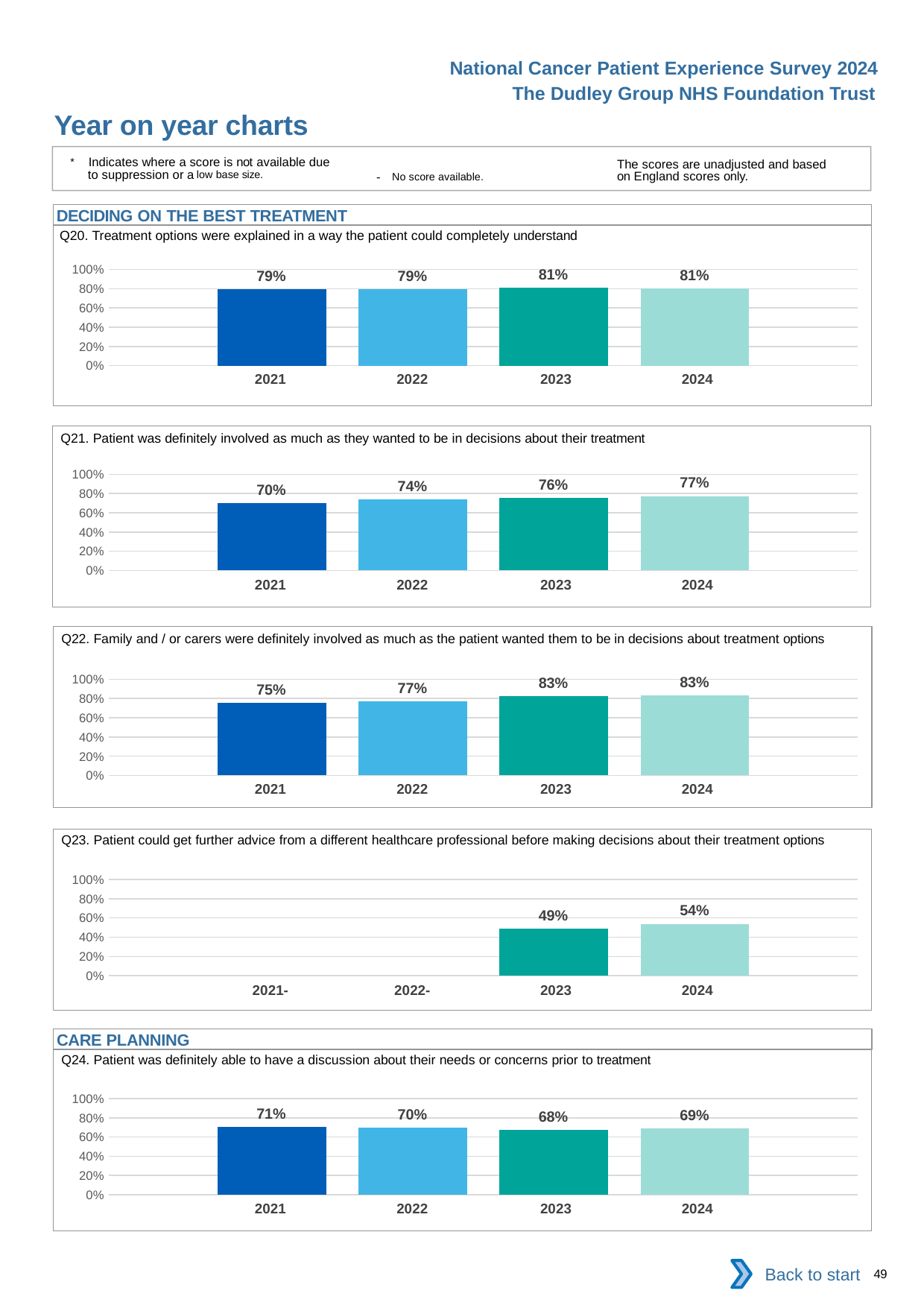
In the Q21 chart, which year has the highest value? 2024 In the Q23 chart, how many years have a bar plotted? 2 What kind of chart is the Q20 chart? Bar chart In the Q23 chart, what is the value for 2024? 54% In the Q22 chart, what is the value for 2022? 77% In the Q21 chart, what is the difference between the 2024 and 2021 values? 7% In the Q24 chart, which is larger, the value for 2021 or the value for 2023? 2021 In the Q23 chart, is the value for 2023 greater or less than 60%? less In the Q20 chart, what is the value for 2023? 81% In the Q24 chart, what is the difference between the 2021 and 2023 values? 3% In the Q22 chart, which year has the lowest value? 2021 In the Q21 chart, what is the value for 2021? 70%